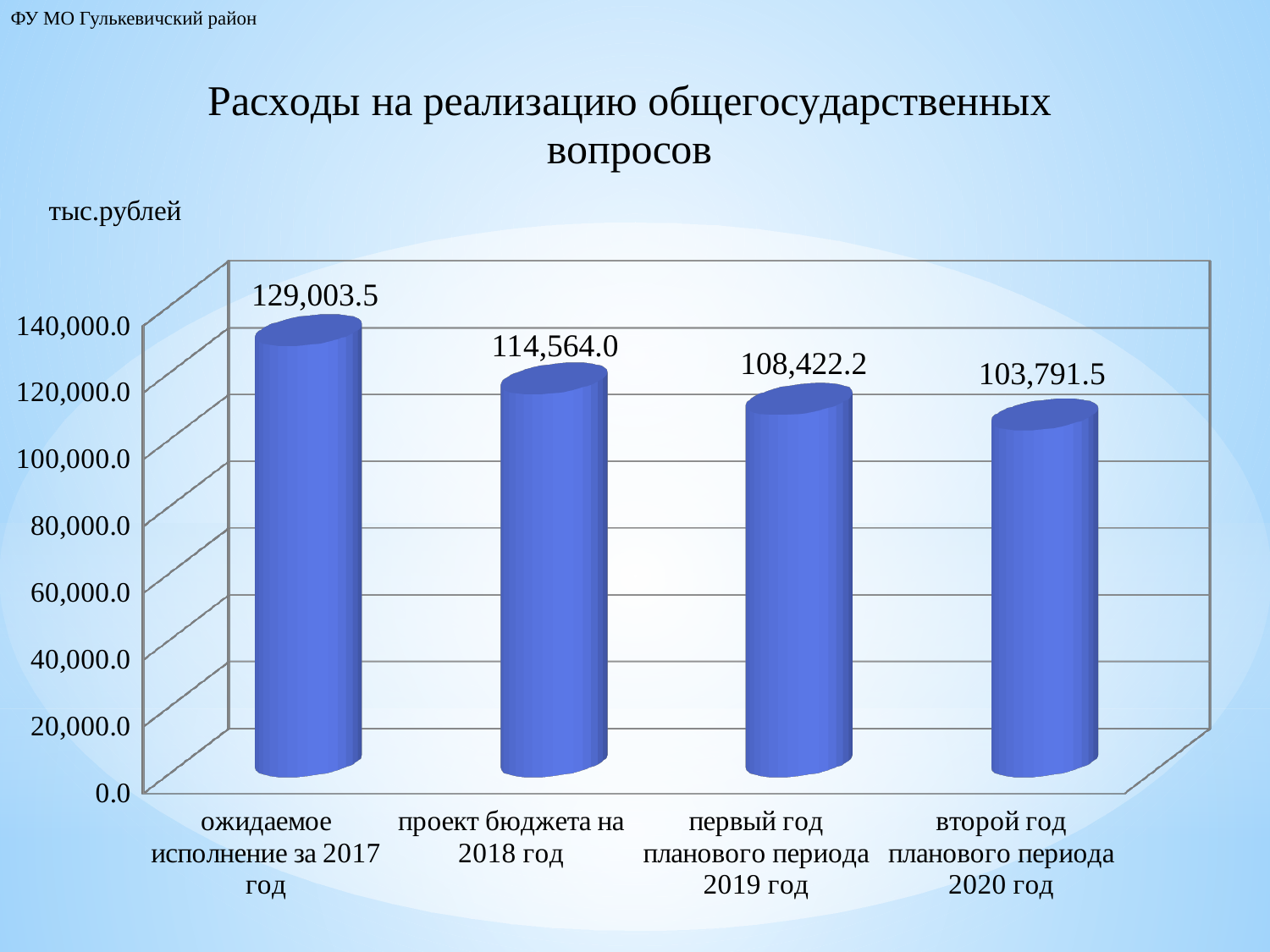
How many categories are shown in the chart? 4 What is the difference between the values for "первый год планового периода 2019 год" and "второй год планового периода 2020 год"? 4,630.7 What is the value for "проект бюджета на 2018 год"? 114,564.0 What is the value for "первый год планового периода 2019 год"? 108,422.2 What kind of chart is shown on the slide? bar chart Which is larger: the value for "проект бюджета на 2018 год" or for "первый год планового периода 2019 год"? проект бюджета на 2018 год What is the difference between the values for "ожидаемое исполнение за 2017 год" and "проект бюджета на 2018 год"? 14,439.5 Which category has the lowest value? второй год планового периода 2020 год Do the values rise or fall from left to right along the x axis? fall What is the value for "второй год планового периода 2020 год"? 103,791.5 Which category has the highest value? ожидаемое исполнение за 2017 год What is the value for "ожидаемое исполнение за 2017 год"? 129,003.5